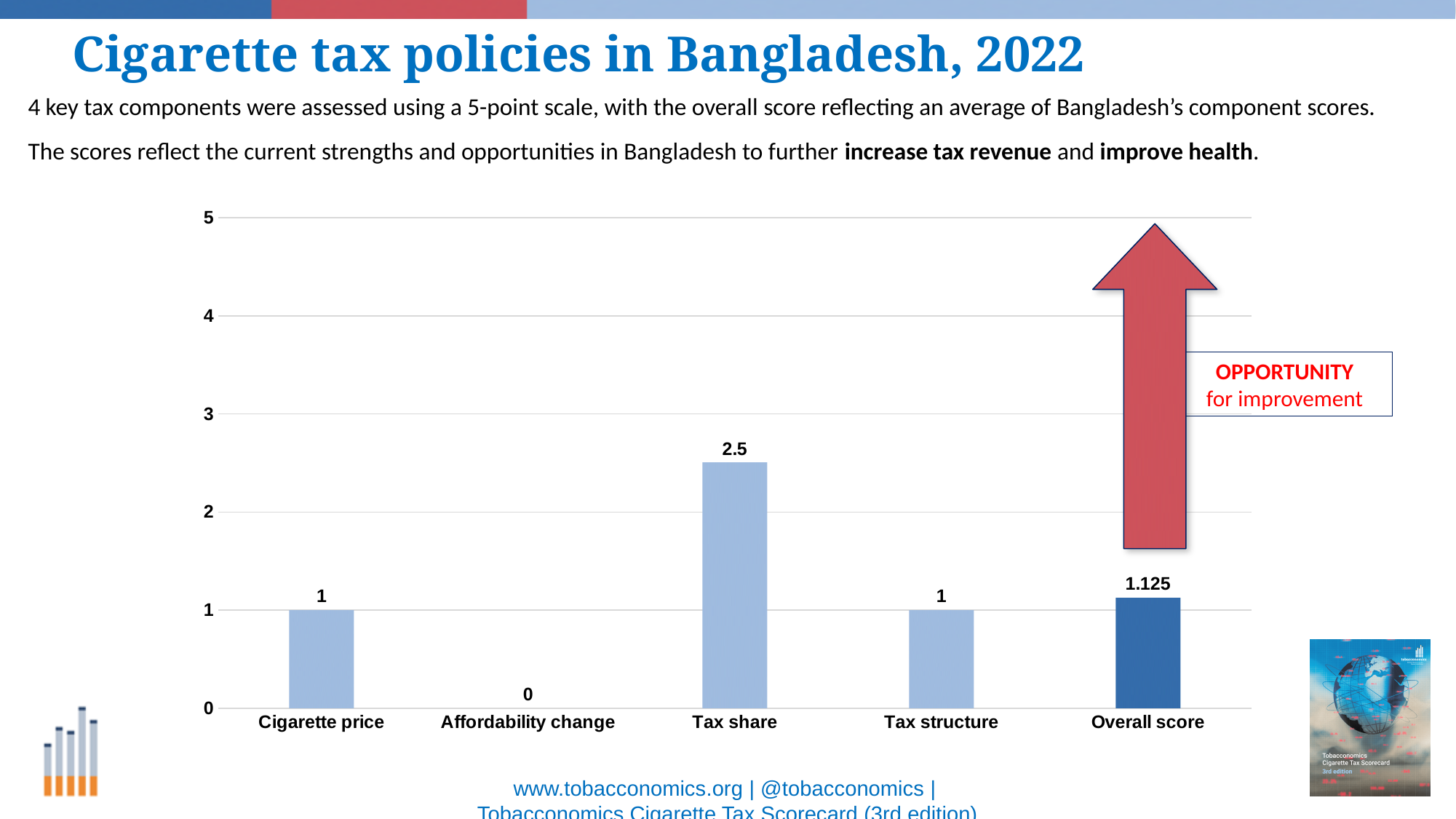
What is the value for Affordability change? 0 Which is larger, the value for Tax share or the value for Overall score? Tax share Which category has the lowest value? Affordability change How many categories are shown on the x axis? 5 What is the value for Cigarette price? 1 What is the value for Overall score? 1.125 Is the value for Tax share greater or less than 2? greater Which category has the highest value? Tax share What kind of chart is shown on the slide? bar chart What is the difference between the values for Tax share and Tax structure? 1.5 What is the value for Tax share? 2.5 What is the maximum value shown on the y axis? 5